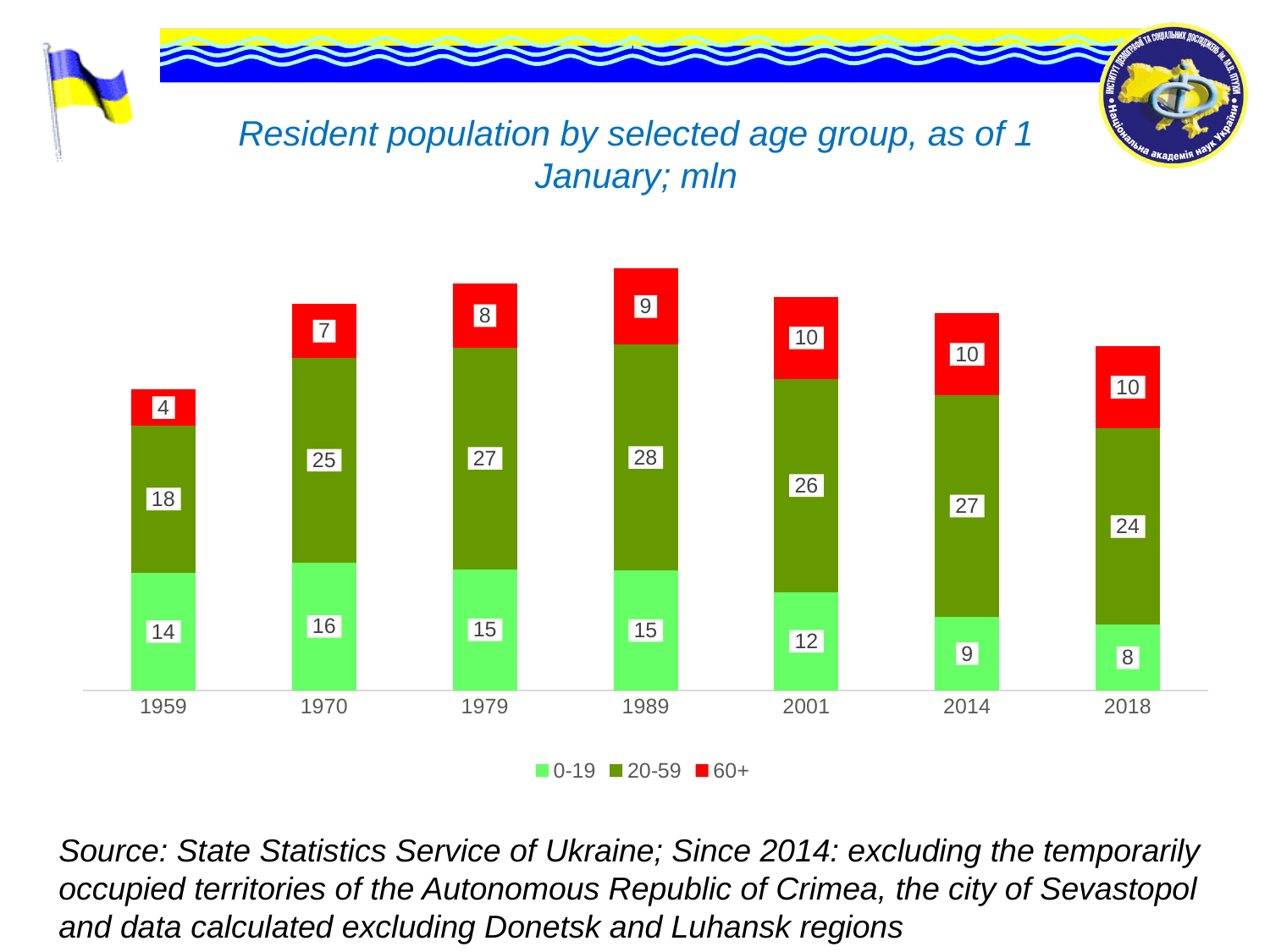
How many series does the legend list? 3 How many years are shown on the x axis? 7 What is the value for the 0-19 age group in 2018? 8 What is the value for the 60+ age group in 1959? 4 What is the value for the 20-59 age group in 1989? 28 What is the total of the stacked bar for 1989? 52 In which year is the 60+ age group value lowest? 1959 In which year is the 0-19 age group value highest? 1970 What is the total of the stacked bar for 1959? 36 What kind of chart is shown on the slide? Stacked bar chart What is the difference between the 20-59 values in 1989 and 2018? 4 Which is larger: the 0-19 value in 2001 or the 0-19 value in 2014? 2001